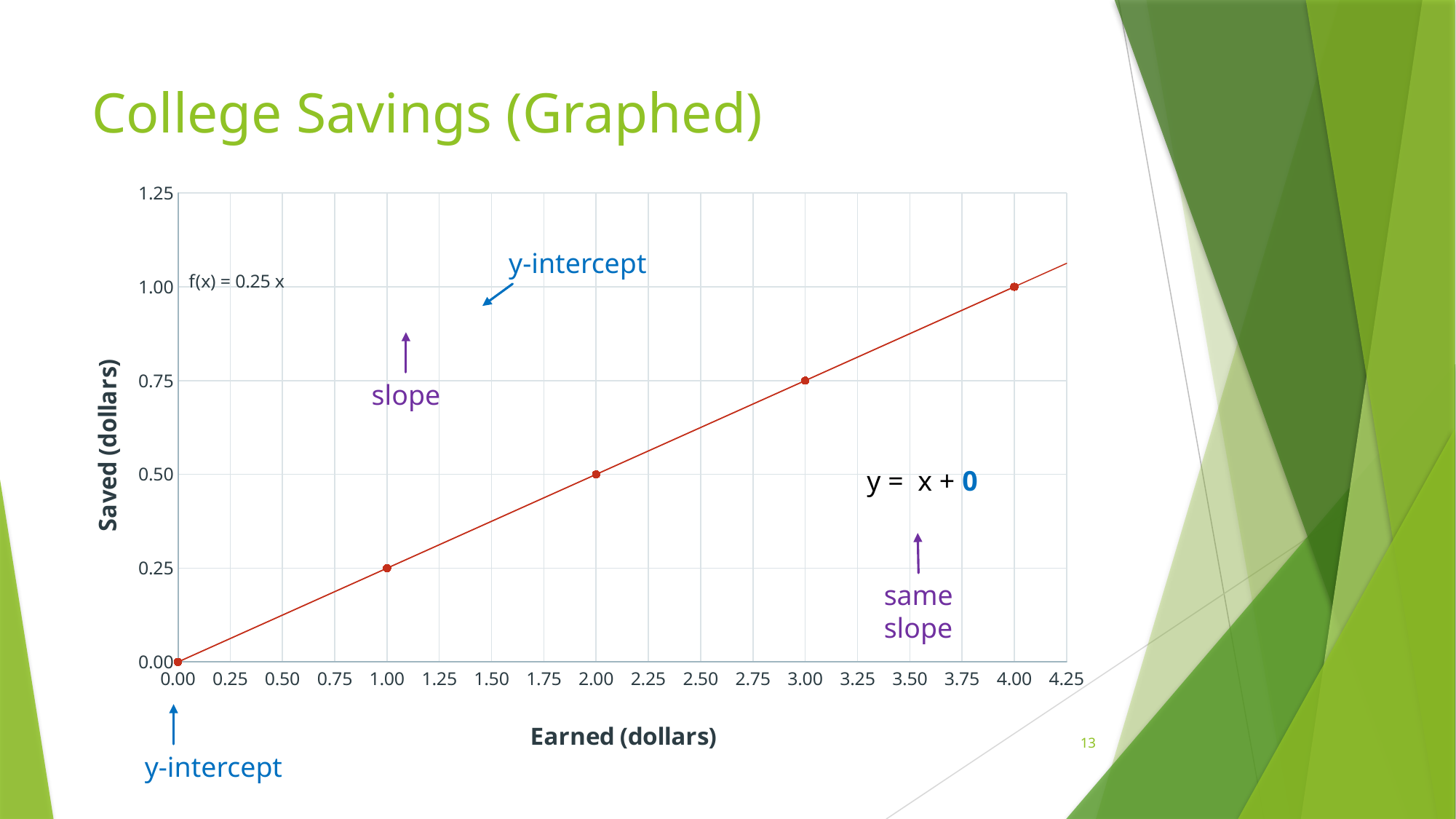
How many data points are plotted on the chart? 5 What kind of chart is shown on the slide? scatter plot with a trend line What is the value of Saved (dollars) when Earned (dollars) is 2.00? 0.50 What is the value of Saved (dollars) when Earned (dollars) is 4.00? 1.00 What is the trend line equation printed on the chart? f(x) = 0.25 x At which Earned (dollars) value is Saved (dollars) the lowest? 0.00 What is the difference in Saved (dollars) between Earned = 3.00 and Earned = 1.00? 0.50 What is the value of Saved (dollars) when Earned (dollars) is 1.00? 0.25 Which has a larger Saved (dollars) value: Earned = 3.00 or Earned = 2.00? Earned = 3.00 Do the Saved (dollars) values rise or fall as Earned (dollars) increases? rise What is the label of the x axis? Earned (dollars) At which Earned (dollars) value is Saved (dollars) the highest? 4.00